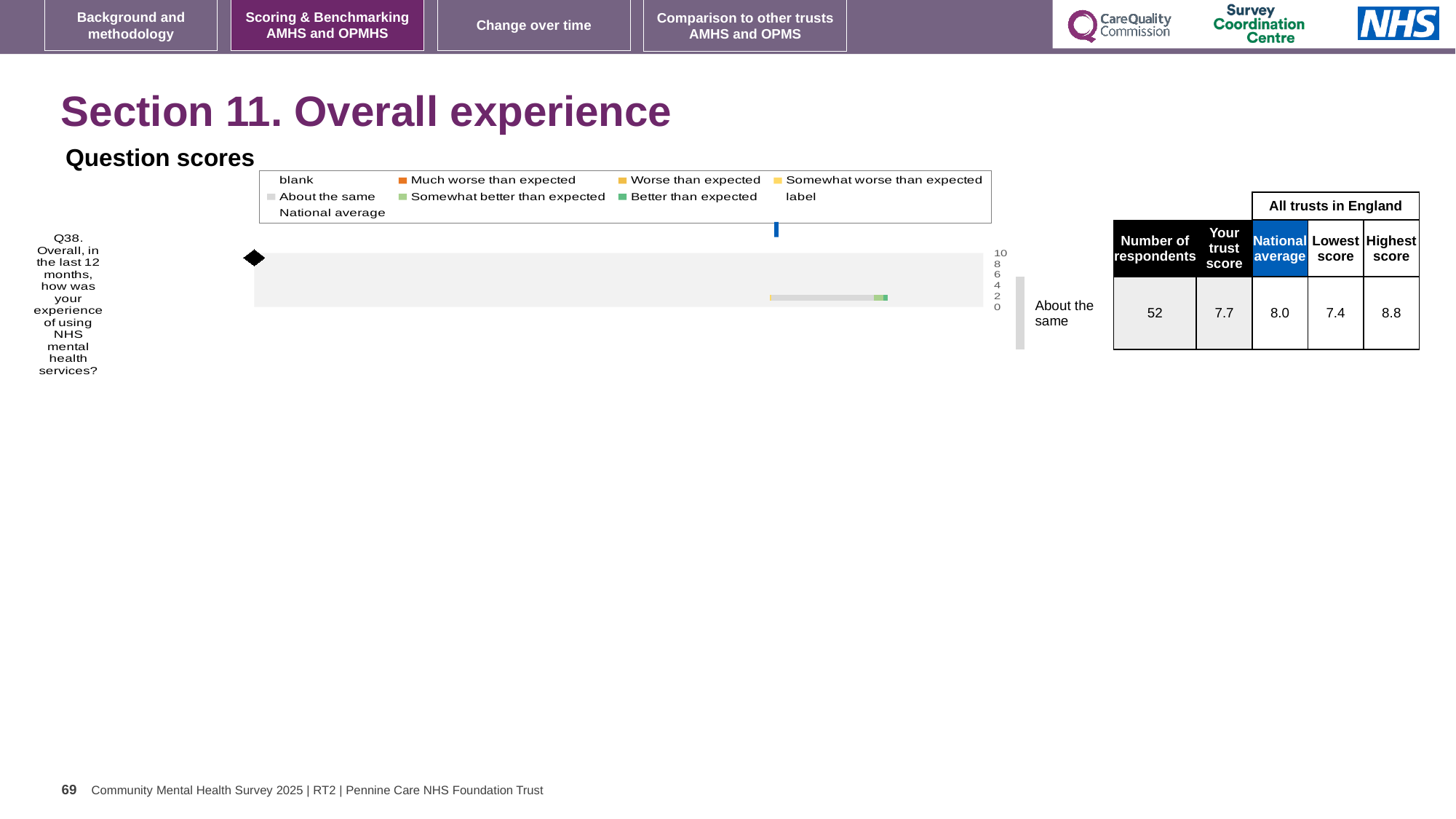
What comparison category is shown next to the chart for Q38? About the same Which question number is plotted in the Question scores chart? Q38 In the table beside the chart, what is the Lowest score among all trusts in England for Q38? 7.4 In the table beside the chart, what is the Highest score among all trusts in England for Q38? 8.8 In the table beside the chart, which is larger for Q38: the trust score or the National average? National average In the table beside the chart, what is the 'Your trust score' for Q38? 7.7 How many questions (categories) are plotted in the Question scores chart? 1 In the table beside the chart, what is the difference between the Highest score and the Lowest score for Q38? 1.4 What is the highest tick value shown on the chart's axis? 10 What kind of chart is shown under 'Question scores'? bar chart In the table beside the chart, what is the National average for Q38? 8.0 In the table beside the chart, what is the number of respondents for Q38? 52